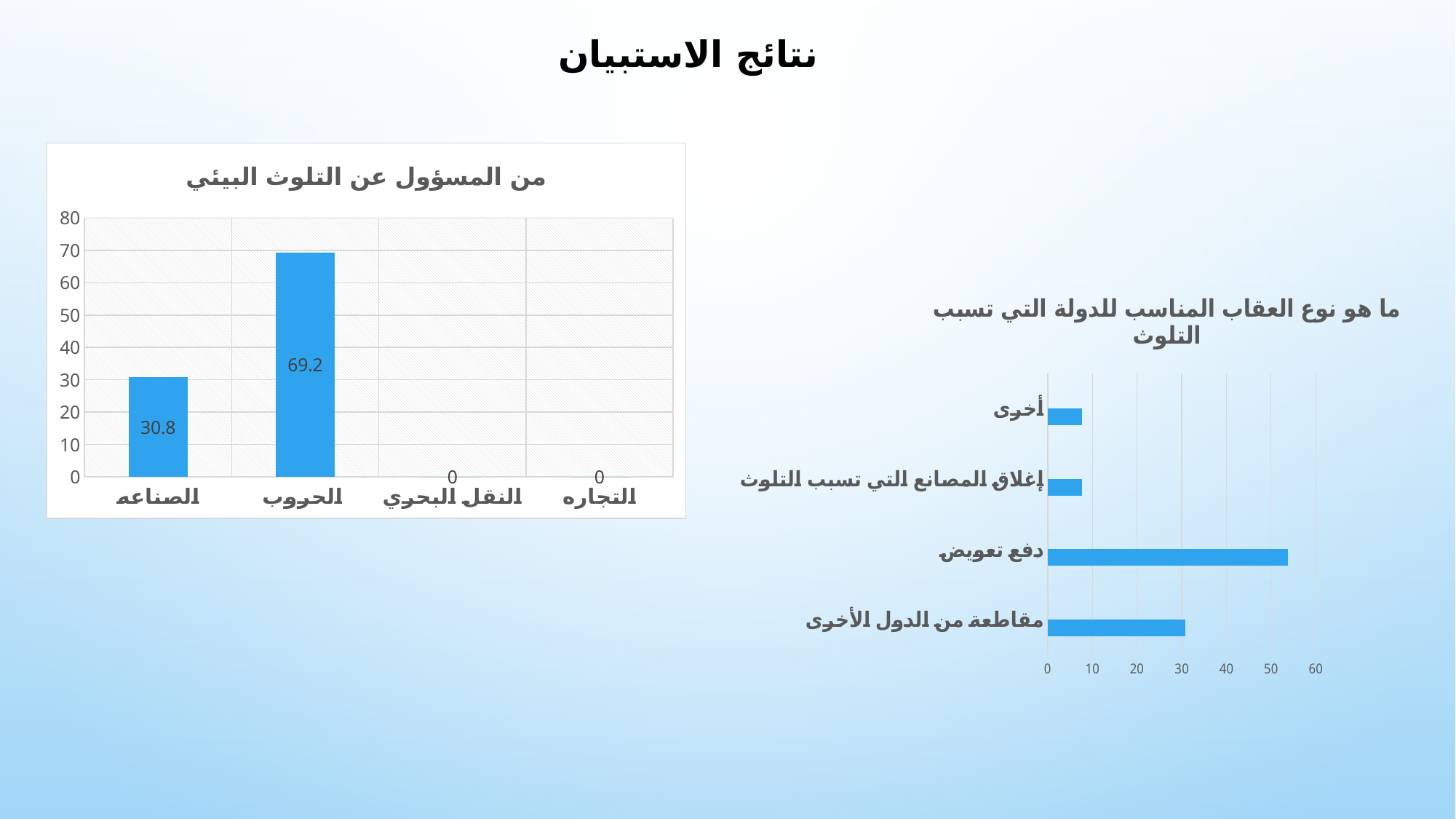
In the chart titled "من المسؤول عن التلوث البيئي", what is the difference between the values for الحروب and الصناعه? 38.4 In the chart titled "ما هو نوع العقاب المناسب للدولة التي تسبب التلوث", is the value for أخرى greater or less than 10? less In the chart titled "ما هو نوع العقاب المناسب للدولة التي تسبب التلوث", how many categories are shown? 4 In the chart titled "من المسؤول عن التلوث البيئي", how many categories are shown on the x axis? 4 What kind of chart is the chart titled "من المسؤول عن التلوث البيئي"? Bar chart In the chart titled "ما هو نوع العقاب المناسب للدولة التي تسبب التلوث", which category has the highest value? دفع تعويض In the chart titled "من المسؤول عن التلوث البيئي", what is the value for التجاره? 0 In the chart titled "من المسؤول عن التلوث البيئي", what is the value for الصناعه? 30.8 In the chart titled "من المسؤول عن التلوث البيئي", what is the value for الحروب? 69.2 In the chart titled "من المسؤول عن التلوث البيئي", which category has the highest value? الحروب In the chart titled "ما هو نوع العقاب المناسب للدولة التي تسبب التلوث", is the value for دفع تعويض greater or less than 50? greater In the chart titled "ما هو نوع العقاب المناسب للدولة التي تسبب التلوث", which is larger: the value for مقاطعة من الدول الأخرى or the value for إغلاق المصانع التي تسبب التلوث? مقاطعة من الدول الأخرى